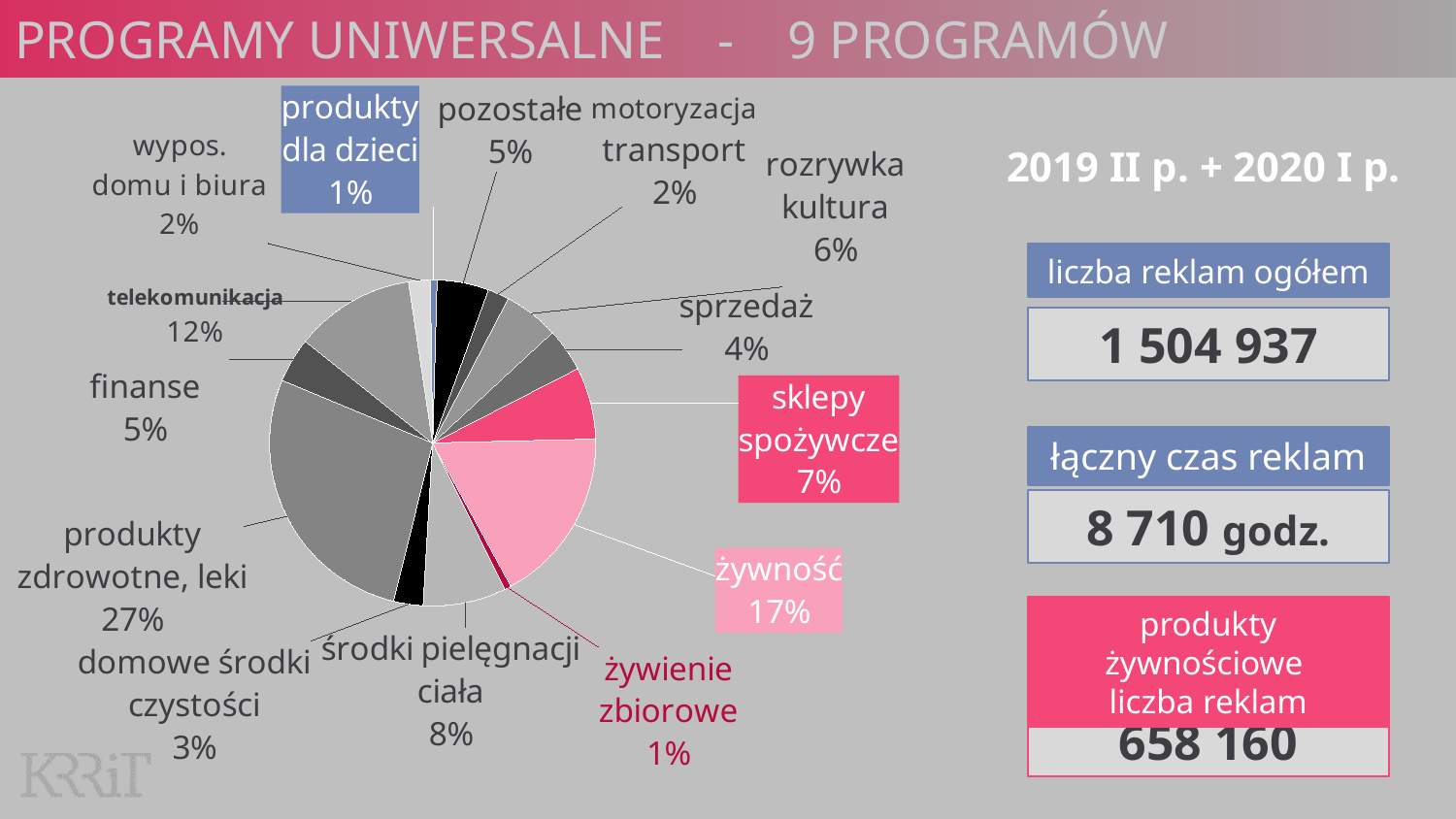
What kind of chart is shown on the slide? pie chart What percentage is shown for "żywność"? 17% How many categories (slices) are labelled in the pie chart? 14 What is the difference in percentage points between "produkty zdrowotne, leki" and "żywność"? 10 What share of the pie does "produkty zdrowotne, leki" have? 27% Which category has the largest share of the pie? produkty zdrowotne, leki What percentage is shown for "sklepy spożywcze"? 7% Which has a larger share: "finanse" or "rozrywka kultura"? rozrywka kultura What percentage is shown for "telekomunikacja"? 12% What is the title at the top of the slide? PROGRAMY UNIWERSALNE - 9 PROGRAMÓW What percentage is shown for "środki pielęgnacji ciała"? 8% Which has a larger share: "telekomunikacja" or "sprzedaż"? telekomunikacja